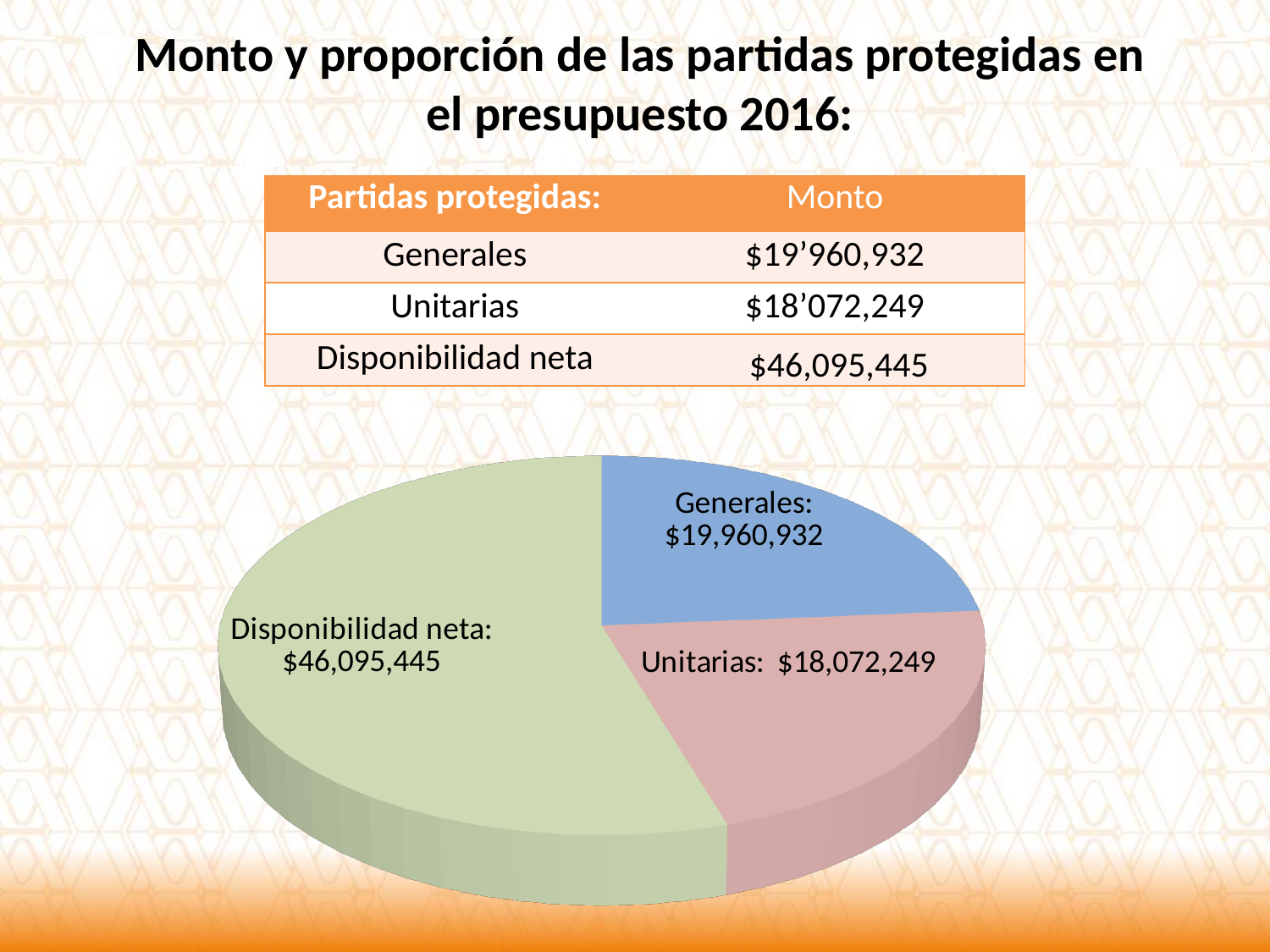
What is the difference between the Generales and Unitarias values in the pie chart? $1,888,683 What is the value of the Disponibilidad neta slice in the pie chart? $46,095,445 How many slices does the pie chart have? 3 Which is larger in the pie chart, Generales or Unitarias? Generales What is the value of the Generales slice in the pie chart? $19,960,932 What colour is the Disponibilidad neta slice in the pie chart? Green What is the value of the Unitarias slice in the pie chart? $18,072,249 What kind of chart is shown on the slide? Pie chart Which slice of the pie chart is the smallest? Unitarias What is the total of all three slices in the pie chart? $84,128,626 Which slice of the pie chart is the largest? Disponibilidad neta What is the difference between the Disponibilidad neta and Generales values in the pie chart? $26,134,513